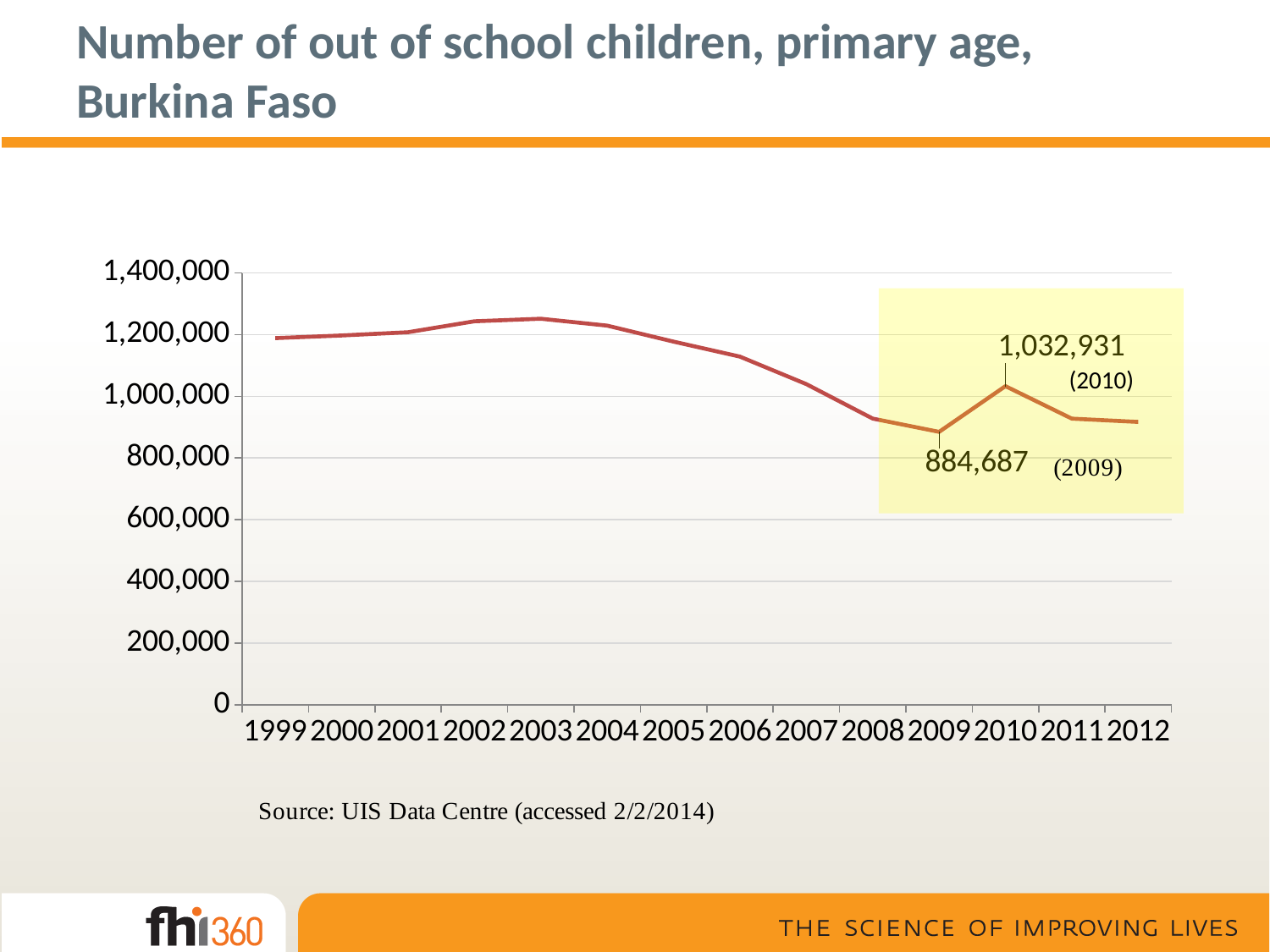
Is the value for 2012 greater or less than 1,000,000? less Which year has the highest number of out of school children? 2003 How many years are plotted on the x axis? 14 Is the value for 1999 greater or less than 1,000,000? greater Which is larger, the value for 2003 or the value for 2012? 2003 Overall, does the number of out of school children rise or fall from 1999 to 2012? fall Is the value for 2003 greater or less than 1,200,000? greater What is the difference between the 2010 value and the 2009 value? 148,244 Which year has the lowest number of out of school children? 2009 What is the number of out of school children in Burkina Faso in 2009? 884,687 What is the number of out of school children in Burkina Faso in 2010? 1,032,931 What type of chart is shown on the slide? line chart